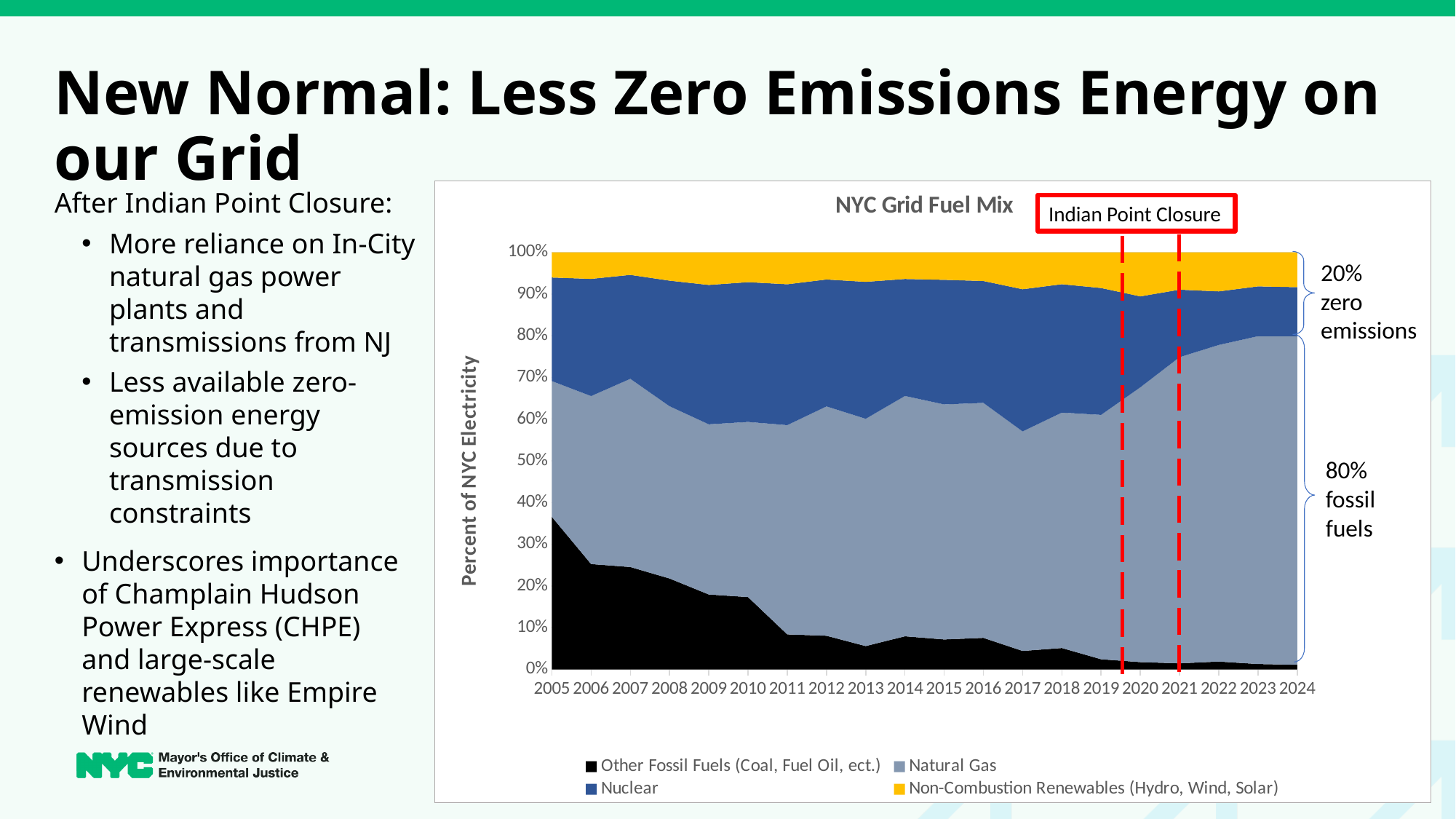
What is the title of the chart on the slide? NYC Grid Fuel Mix In the NYC Grid Fuel Mix chart, does the share of Other Fossil Fuels rise or fall from 2005 to 2024? Fall In the NYC Grid Fuel Mix chart, is the share of Other Fossil Fuels in 2024 greater or less than 10%? less What is the label on the vertical axis of the NYC Grid Fuel Mix chart? Percent of NYC Electricity In the NYC Grid Fuel Mix chart, which series is larger in 2024, Natural Gas or Nuclear? Natural Gas In the NYC Grid Fuel Mix chart, does the share of Natural Gas rise or fall from 2019 to 2024? Rise According to the annotation on the NYC Grid Fuel Mix chart, what percentage of the grid is zero emissions in 2024? 20% According to the annotation on the NYC Grid Fuel Mix chart, what percentage of the grid is fossil fuels in 2024? 80% How many series does the legend of the NYC Grid Fuel Mix chart list? 4 In the NYC Grid Fuel Mix chart, is the share of Other Fossil Fuels in 2005 greater or less than 30%? greater What kind of chart is the NYC Grid Fuel Mix chart? Stacked area chart How many years are shown on the x axis of the NYC Grid Fuel Mix chart? 20